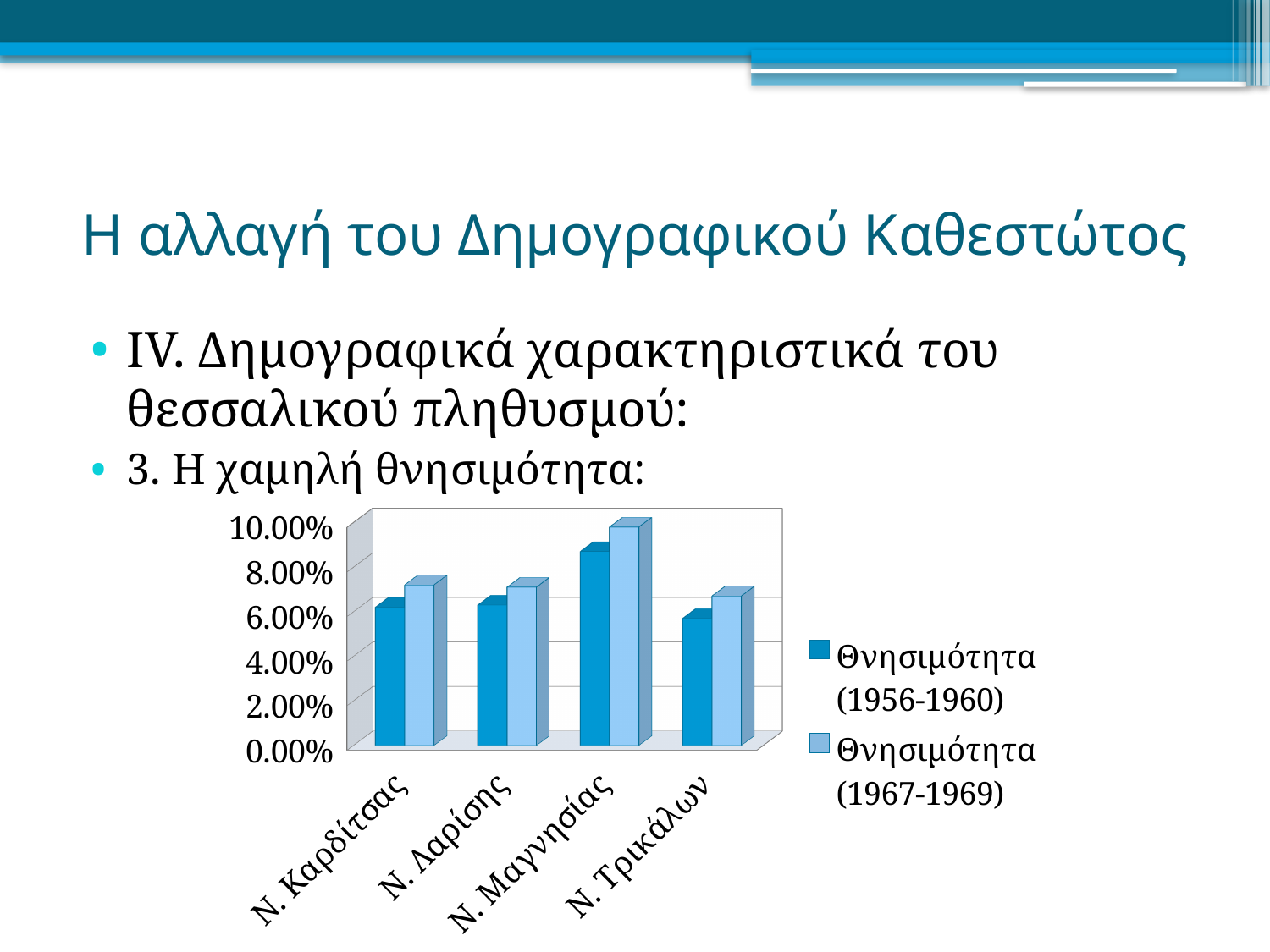
What is the highest value shown on the chart's vertical axis? 10.00% Which category has the lowest value for Θνησιμότητα (1956-1960)? Ν. Τρικάλων What are the two series names listed in the chart's legend? Θνησιμότητα (1956-1960) and Θνησιμότητα (1967-1969) Is the value for Ν. Τρικάλων in Θνησιμότητα (1956-1960) greater or less than 6.00%? less How many series does the chart's legend list? 2 Is the value for Ν. Καρδίτσας in Θνησιμότητα (1967-1969) greater or less than 6.00%? greater Which category has the highest value for Θνησιμότητα (1956-1960)? Ν. Μαγνησίας Is the value for Ν. Μαγνησίας in Θνησιμότητα (1956-1960) greater or less than 8.00%? greater How many categories (prefectures) are shown on the x axis of the chart? 4 For Ν. Μαγνησίας, which is larger: Θνησιμότητα (1956-1960) or Θνησιμότητα (1967-1969)? Θνησιμότητα (1967-1969) Which category has the highest value for Θνησιμότητα (1967-1969)? Ν. Μαγνησίας What kind of chart is shown on the slide? Bar chart